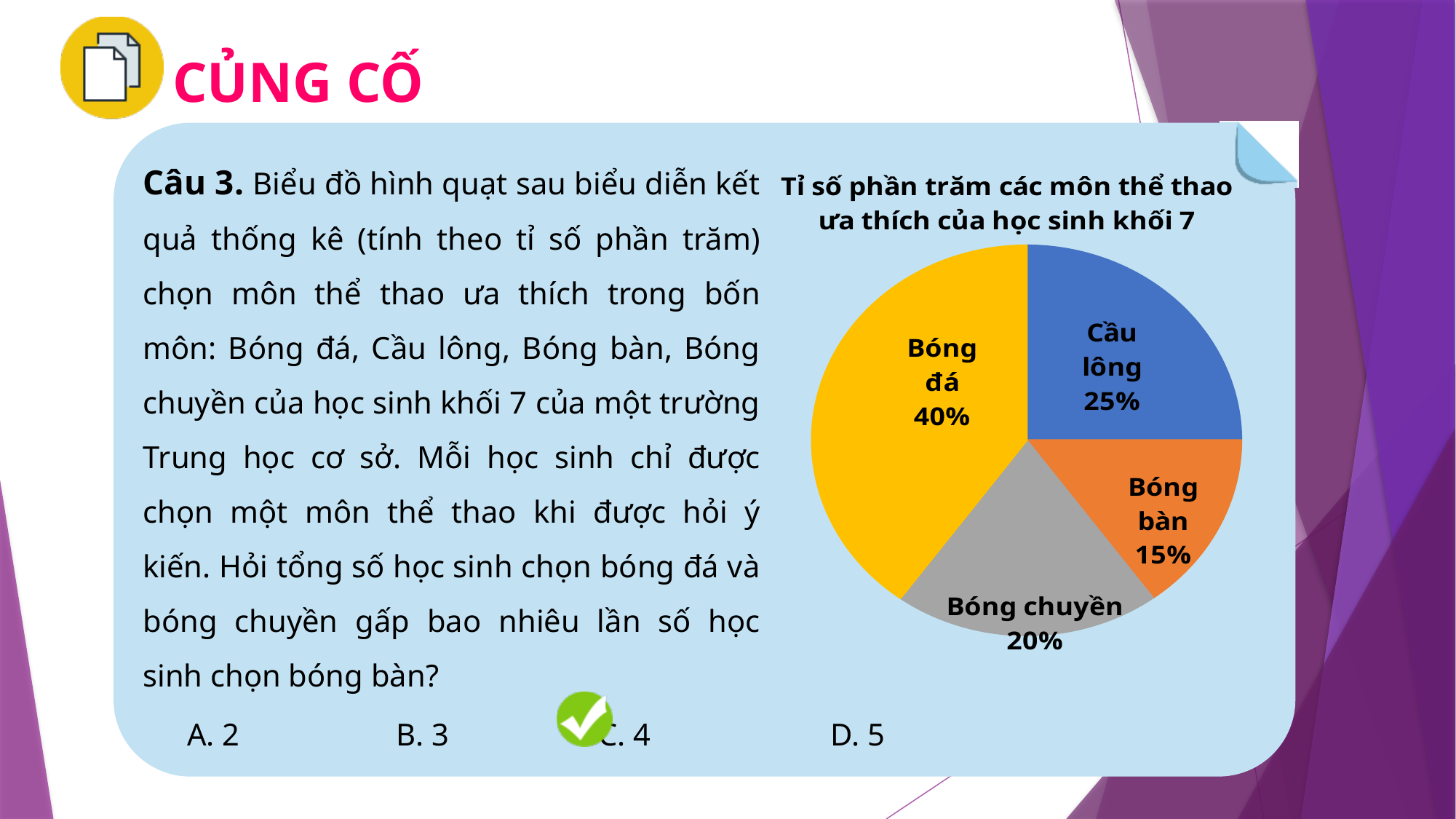
What is the title of the pie chart? Tỉ số phần trăm các môn thể thao ưa thích của học sinh khối 7 What percentage of the pie chart is Bóng chuyền? 20% What colour is the Bóng đá slice in the pie chart? Yellow What percentage of the pie chart is Cầu lông? 25% What percentage of the pie chart is Bóng bàn? 15% Which sport has the largest slice of the pie chart? Bóng đá What is the difference in percentage points between Bóng đá and Bóng bàn? 25 Which is larger, the share for Cầu lông or the share for Bóng chuyền? Cầu lông Which sport has the smallest slice of the pie chart? Bóng bàn How many slices does the pie chart have? 4 What percentage of the pie chart is Bóng đá? 40% What kind of chart is shown on the slide? Pie chart